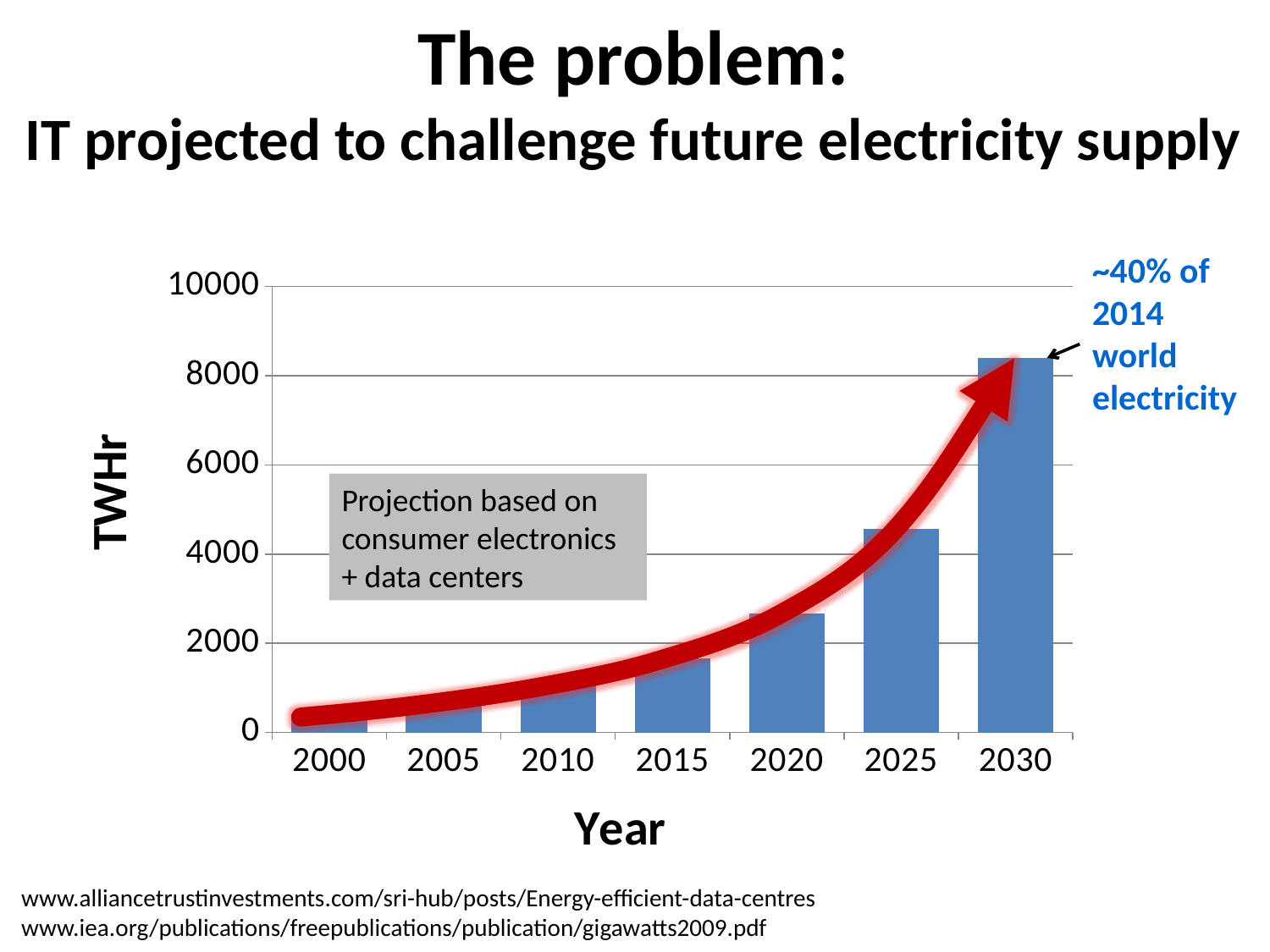
Is the value for 2020 greater or less than 2000? greater Which year has the highest value in the chart? 2030 Is the value for 2025 greater or less than 4000? greater How many years are plotted on the x axis of the chart? 7 Do the values rise or fall from 2000 to 2030? rise Is the value for 2030 greater or less than 8000? greater What kind of chart is shown on the slide? bar chart Which year has the lowest value in the chart? 2000 What is the label on the x axis of the chart? Year What is the label on the y axis of the chart? TWHr Which year has the larger value, 2020 or 2025? 2025